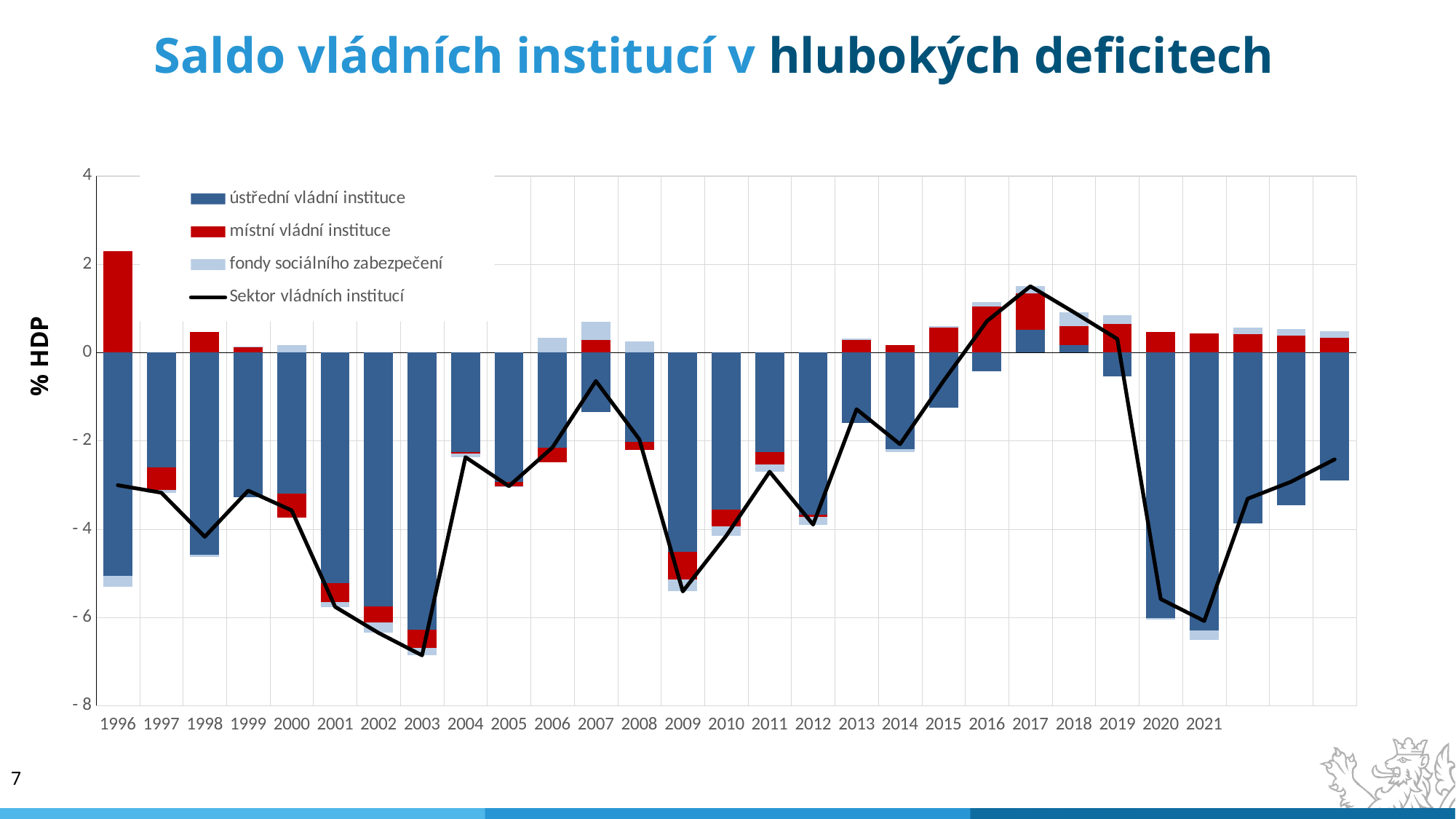
Is the value of the Sektor vládních institucí line in 2007 greater or less than -2? greater In which year does the Sektor vládních institucí line reach its lowest value? 2003 Is the value of the Sektor vládních institucí line in 2017 greater or less than 0? greater What kind of chart is shown on the slide? Bar chart with a line Is the value of the Sektor vládních institucí line in 2009 greater or less than -4? less How many series does the legend list? 4 Does the Sektor vládních institucí line rise or fall from 2019 to 2021? fall Which series is drawn as a black line? Sektor vládních institucí What is the label on the vertical axis? % HDP Which year has the higher value on the Sektor vládních institucí line, 2017 or 2020? 2017 In which year does the Sektor vládních institucí line reach its highest value? 2017